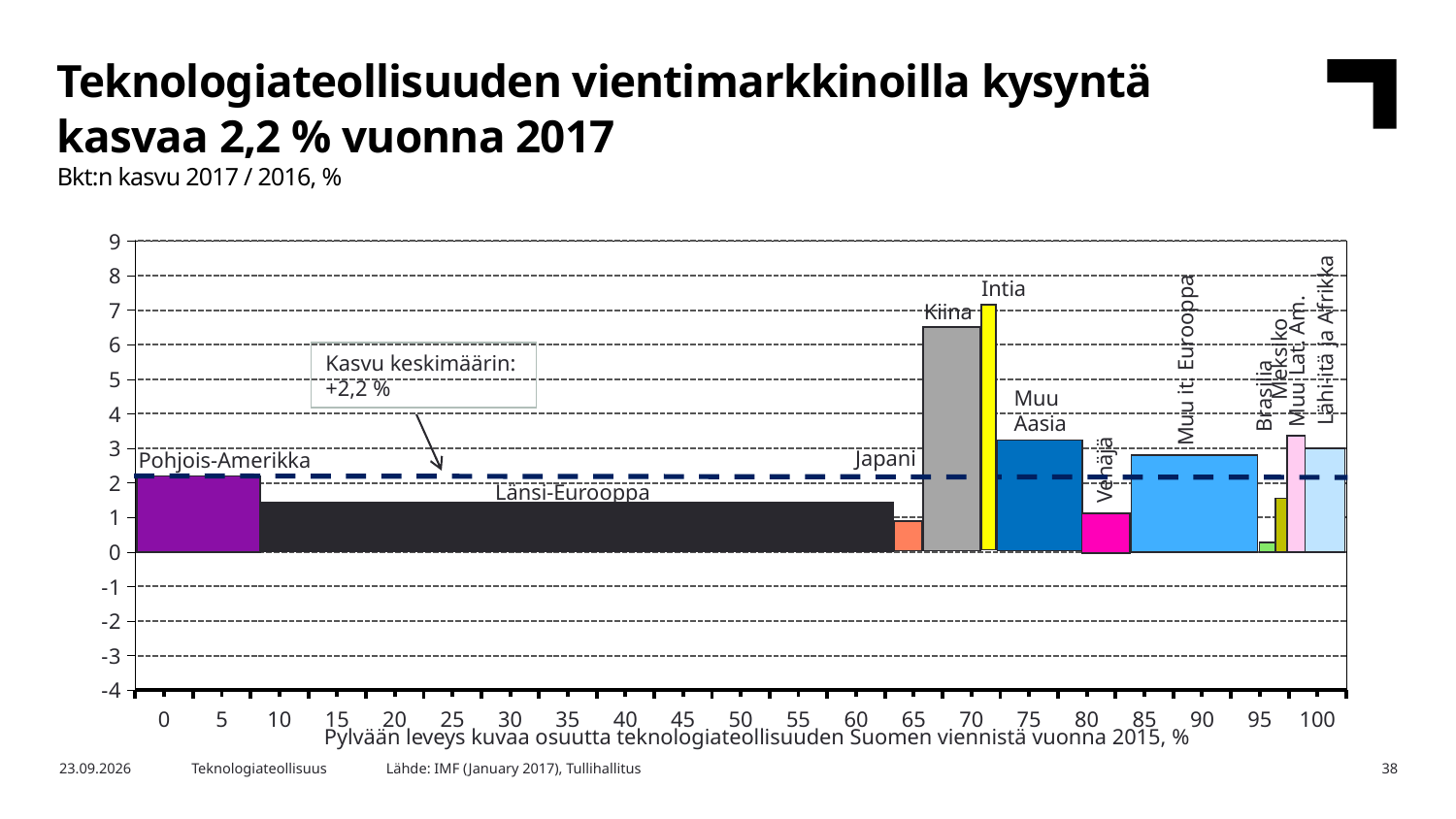
Is the value for Länsi-Eurooppa greater or less than 2? less How many regions are shown as bars in the chart? 12 What kind of chart is shown on the slide? Bar chart Which region has the highest GDP growth in the chart? Intia Is the value for Kiina greater or less than 5? greater Which region has the lowest GDP growth in the chart? Brasilia Is the value for Japani greater or less than 2? less Which has the higher value, Pohjois-Amerikka or Länsi-Eurooppa? Pohjois-Amerikka Which has the higher value, Kiina or Japani? Kiina Which region has the widest bar in the chart? Länsi-Eurooppa What average growth value is printed in the text box on the chart? +2,2 %